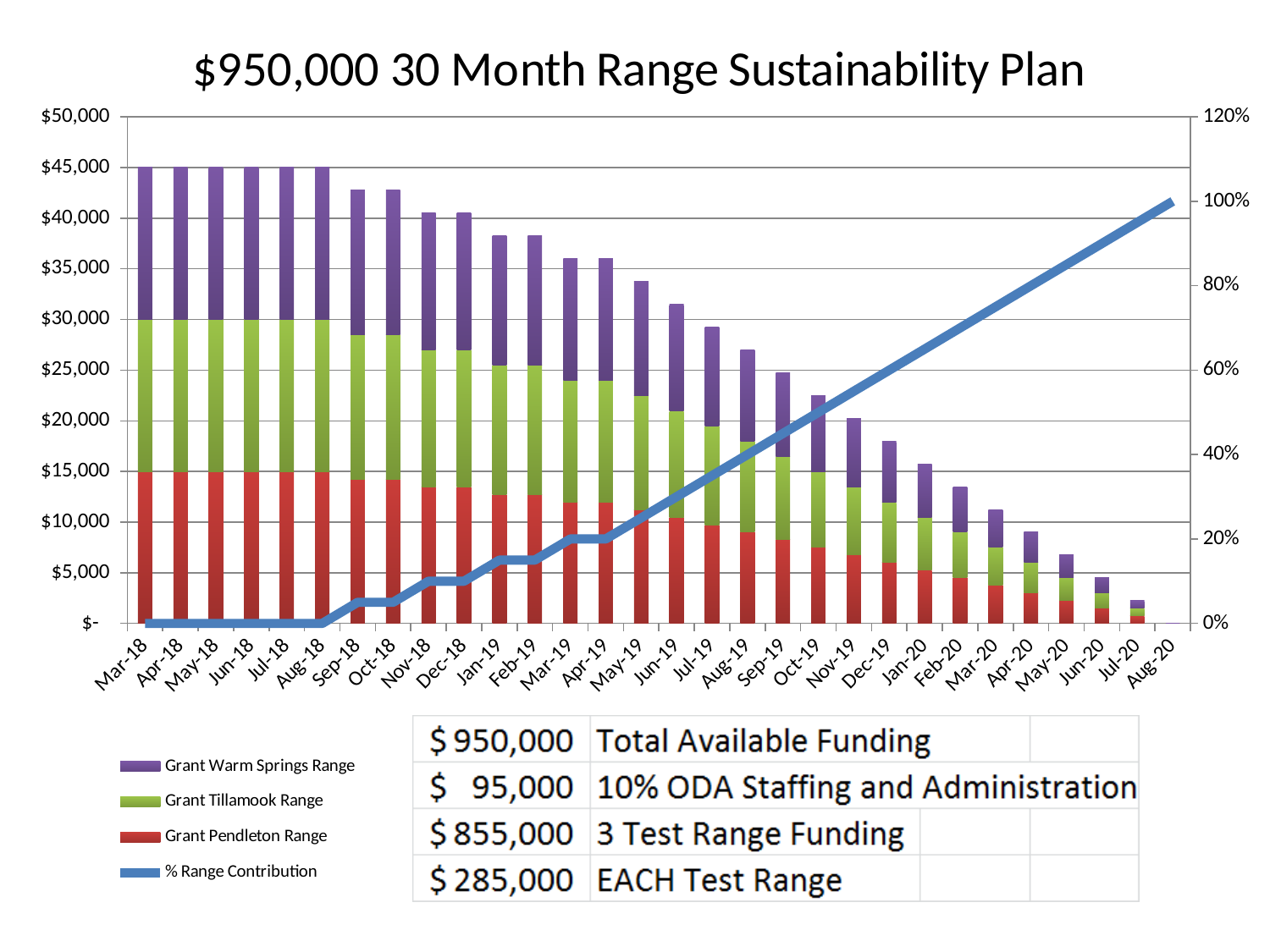
How many months are plotted along the x axis? 30 Is the total stacked bar value for Mar-18 greater or less than $40,000? greater Which month has the highest % Range Contribution? Aug-20 Do the total heights of the stacked grant bars rise or fall from Mar-18 to Aug-20? fall Is the % Range Contribution for Mar-19 greater or less than 40%? less How many series does the legend list? 4 What kind of chart is shown on the slide? bar and line chart Is the % Range Contribution for Aug-20 greater or less than 80%? greater Is the total stacked bar value for Jan-19 larger or smaller than for Jan-20? larger What is the title of the chart? $950,000 30 Month Range Sustainability Plan Does the % Range Contribution line rise or fall from Mar-18 to Aug-20? rise